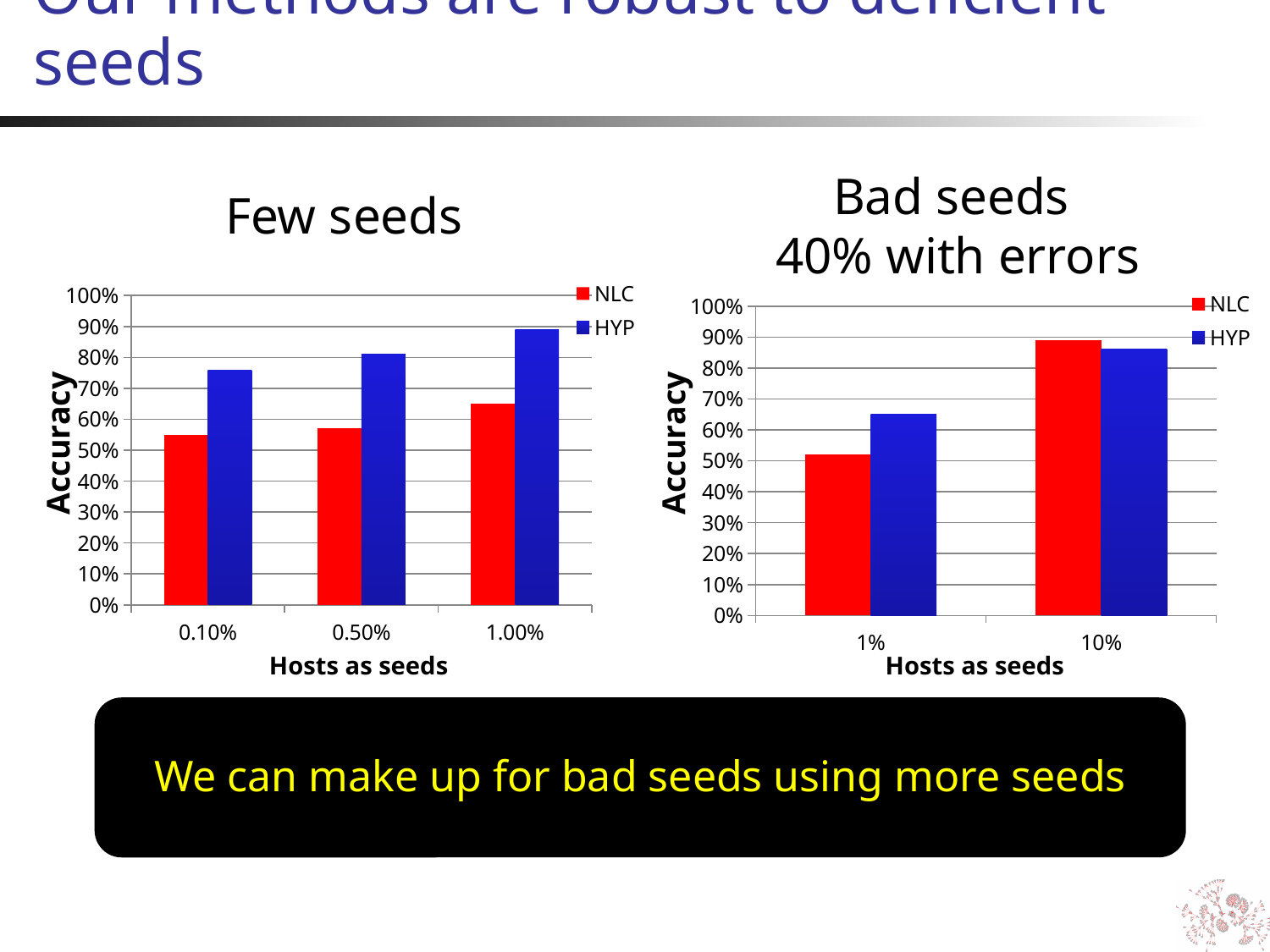
In the "Few seeds" chart, is the NLC value at 1.00% greater or less than 70%? less In the "Bad seeds 40% with errors" chart, is the NLC value at 1% greater or less than 60%? less In the "Few seeds" chart, is the HYP value at 0.10% greater or less than 80%? less In the "Bad seeds 40% with errors" chart, which series is higher at 1%, NLC or HYP? HYP What kind of chart is the "Few seeds" chart? bar chart How many categories are shown on the x axis of the "Bad seeds 40% with errors" chart? 2 In the "Few seeds" chart, does the HYP accuracy rise or fall as the share of hosts as seeds increases? rise How many categories are shown on the x axis of the "Few seeds" chart? 3 How many series does the legend of the "Few seeds" chart list? 2 In the "Few seeds" chart, which series is higher at 0.50%, NLC or HYP? HYP